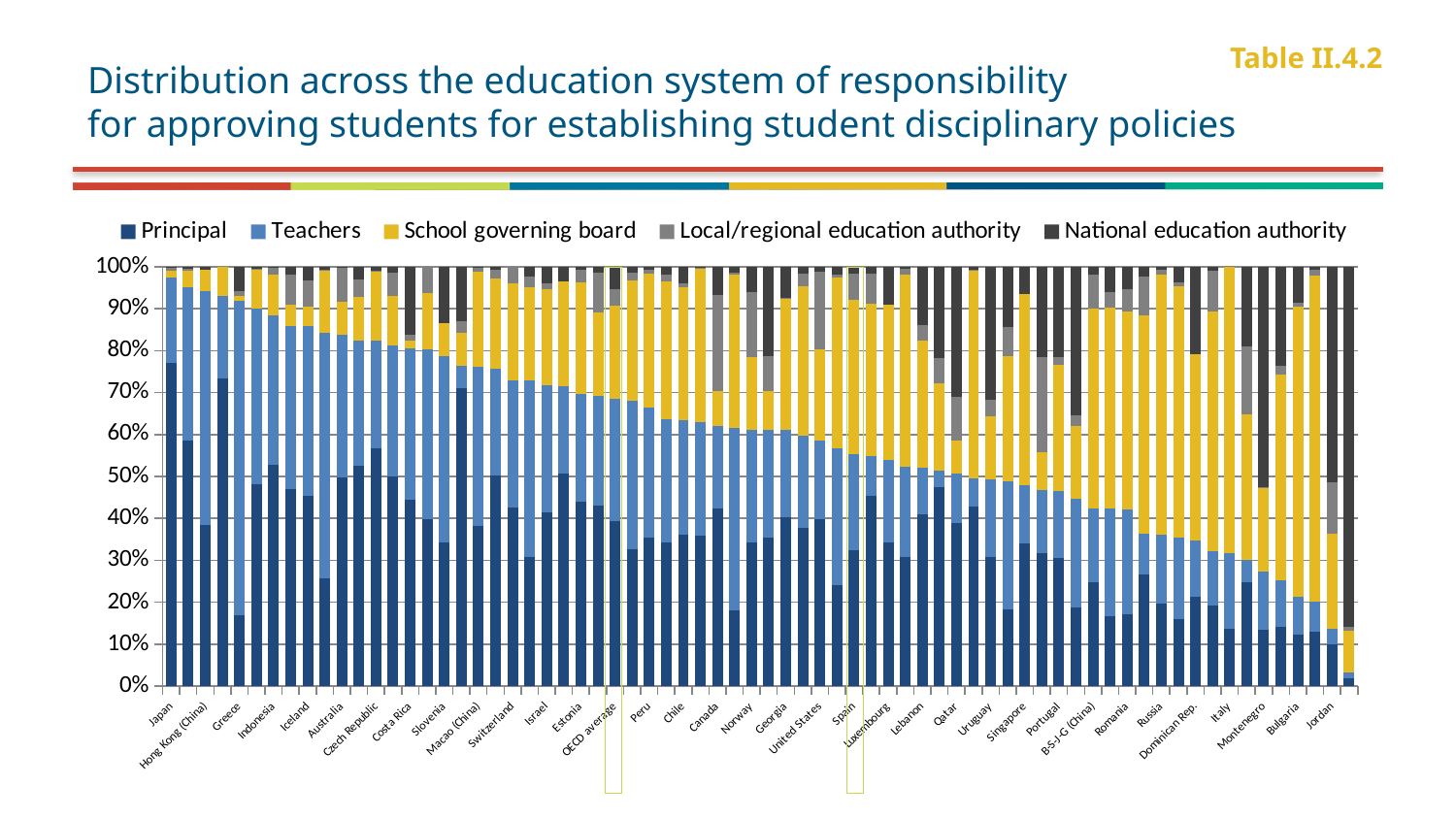
Does the Principal share generally rise or fall moving from left to right across the countries? fall Which series is listed last in the legend? National education authority Is the Principal value for Japan greater or less than 90%? less Is the Principal value for Japan greater or less than 70%? greater How many series does the legend list? 5 Which series is listed first in the legend? Principal What kind of chart is shown on the slide? Stacked bar chart